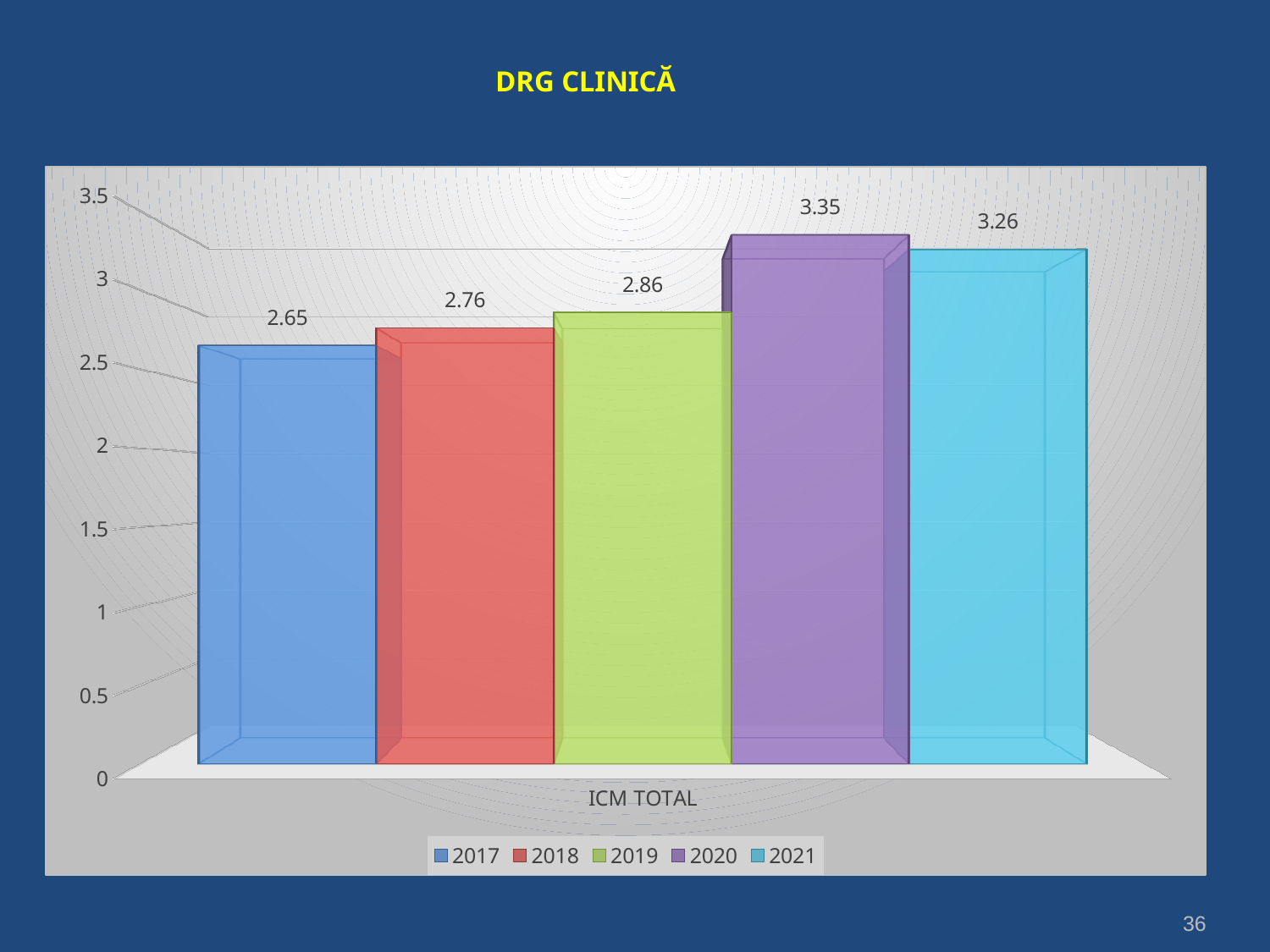
What kind of chart is shown on the slide? bar chart What is the title of the slide above the chart? DRG CLINICĂ Which year has the highest ICM TOTAL value? 2020 Is the value for 2018 greater or less than 3? less Which year has the lowest ICM TOTAL value? 2017 What is the difference between the 2019 and 2018 values? 0.1 What is the ICM TOTAL value for 2017? 2.65 Which is larger, the value for 2021 or the value for 2019? 2021 How many series does the legend list? 5 What is the ICM TOTAL value for 2020? 3.35 What is the ICM TOTAL value for 2021? 3.26 What is the difference between the 2020 and 2017 values? 0.7